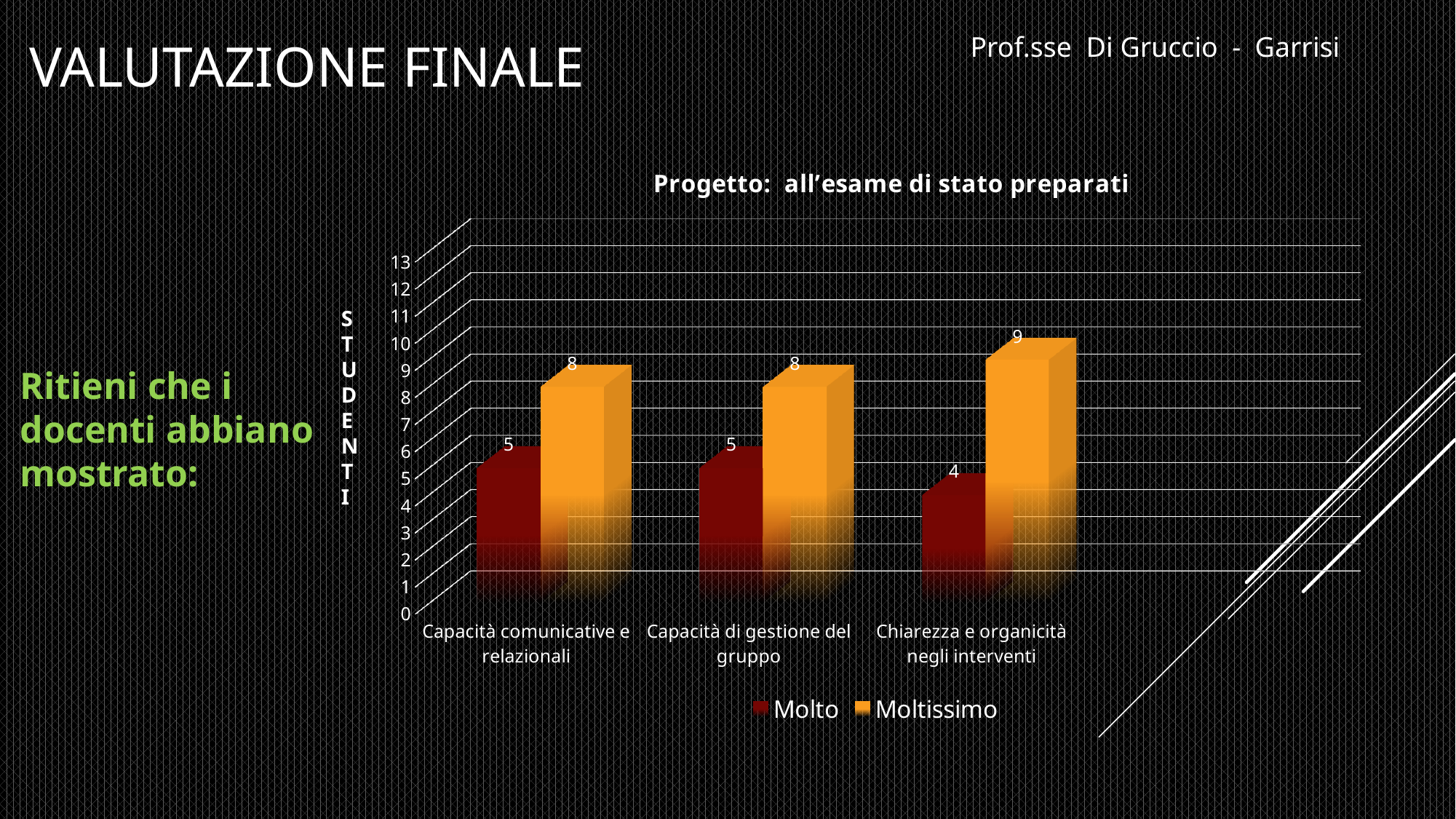
How many categories are shown on the x axis? 3 In which category does the Moltissimo series reach its highest value? Chiarezza e organicità negli interventi What is the value for Moltissimo in the category 'Chiarezza e organicità negli interventi'? 9 What is the value for Molto in the category 'Capacità comunicative e relazionali'? 5 What is the difference between the Moltissimo and Molto values for 'Chiarezza e organicità negli interventi'? 5 What is the value for Molto in the category 'Chiarezza e organicità negli interventi'? 4 In which category does the Molto series have its lowest value? Chiarezza e organicità negli interventi What is the value for Moltissimo in the category 'Capacità di gestione del gruppo'? 8 How many series does the legend list? 2 What kind of chart is shown on the slide? Bar chart What is the title of the chart? Progetto: all'esame di stato preparati Which is larger for 'Capacità di gestione del gruppo': Molto or Moltissimo? Moltissimo